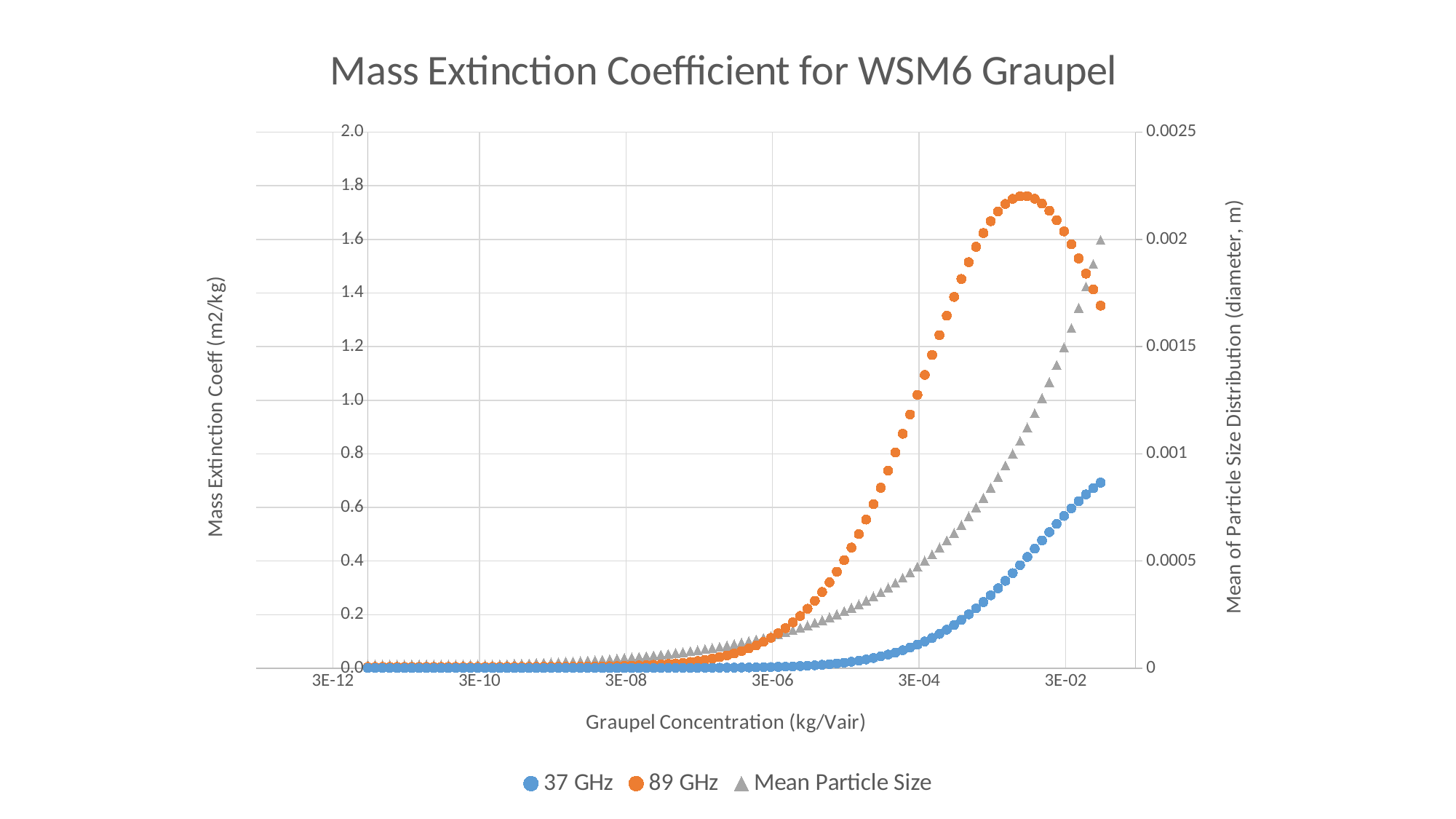
Which series reaches the higher peak mass extinction coefficient, 37 GHz or 89 GHz? 89 GHz Is the highest value of the 37 GHz series greater or less than 0.8? less Is the Mean Particle Size value at a graupel concentration of 3E-04 greater or less than 0.0005? less At a graupel concentration of 3E-04, which series has the larger mass extinction coefficient, 37 GHz or 89 GHz? 89 GHz Is the 89 GHz value at a graupel concentration of 3E-06 greater or less than 0.2? less How many series does the legend list? 3 What is the label of the horizontal axis? Graupel Concentration (kg/Vair) Does the 89 GHz series keep rising to the right end of the x axis, or does it rise and then fall? rises and then falls Does the 37 GHz series rise or fall as graupel concentration increases? rises What is the title of the chart? Mass Extinction Coefficient for WSM6 Graupel What kind of chart is shown on the slide? scatter chart